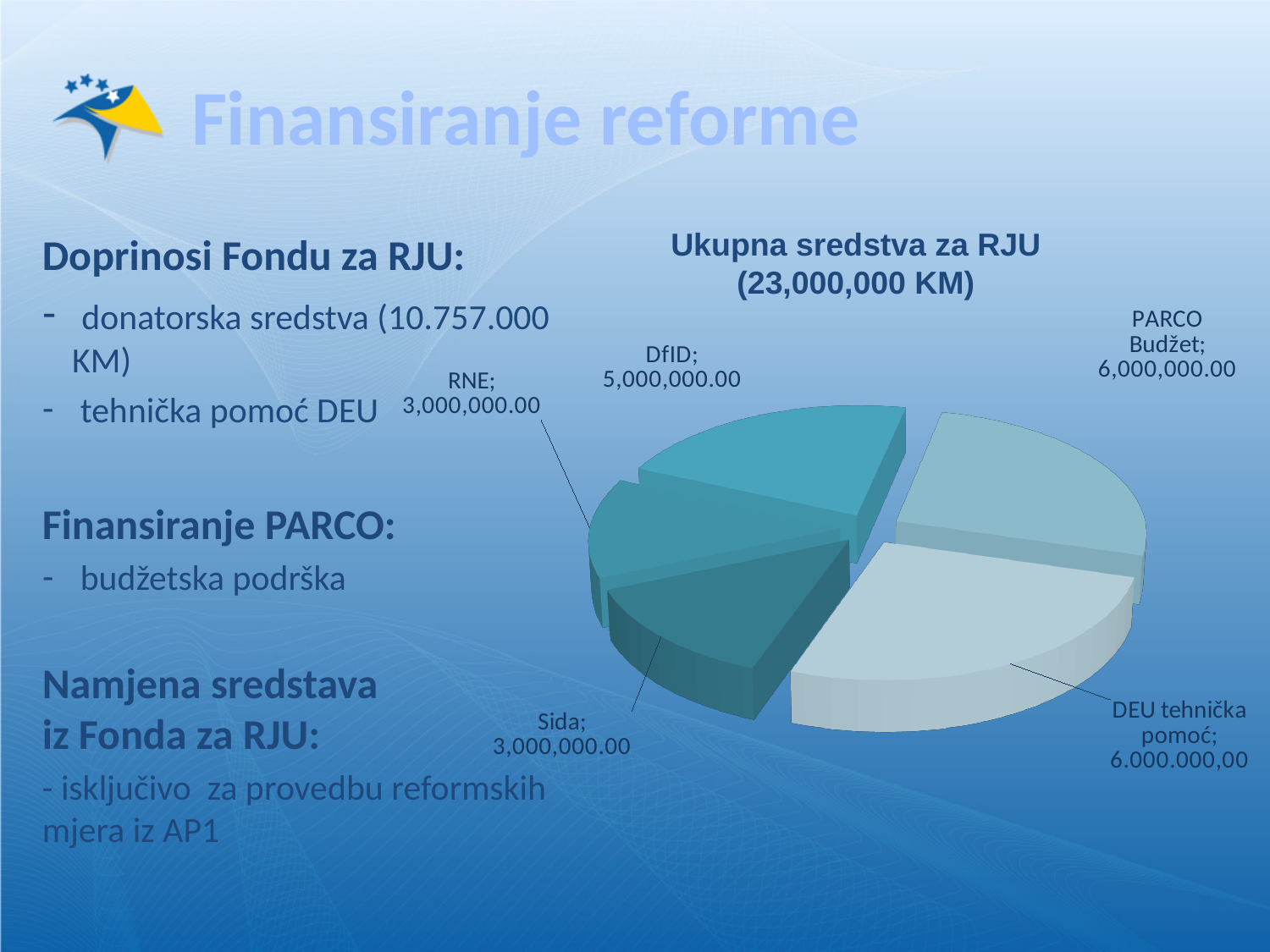
What is the value for Sida in the pie chart? 3,000,000.00 What is the value for DEU tehnička pomoć in the pie chart? 6.000.000,00 What is the difference between the DfID value and the Sida value in the pie chart? 2,000,000.00 What is the difference between the PARCO Budžet value and the DfID value in the pie chart? 1,000,000.00 What is the title of the pie chart? Ukupna sredstva za RJU (23,000,000 KM) How many slices does the pie chart have? 5 Which is larger in the pie chart, DfID or RNE? DfID What is the value for RNE in the pie chart? 3,000,000.00 What is the value for PARCO Budžet in the pie chart? 6,000,000.00 What is the value for DfID in the pie chart? 5,000,000.00 What kind of chart is shown on the slide? pie chart Which is larger in the pie chart, PARCO Budžet or Sida? PARCO Budžet